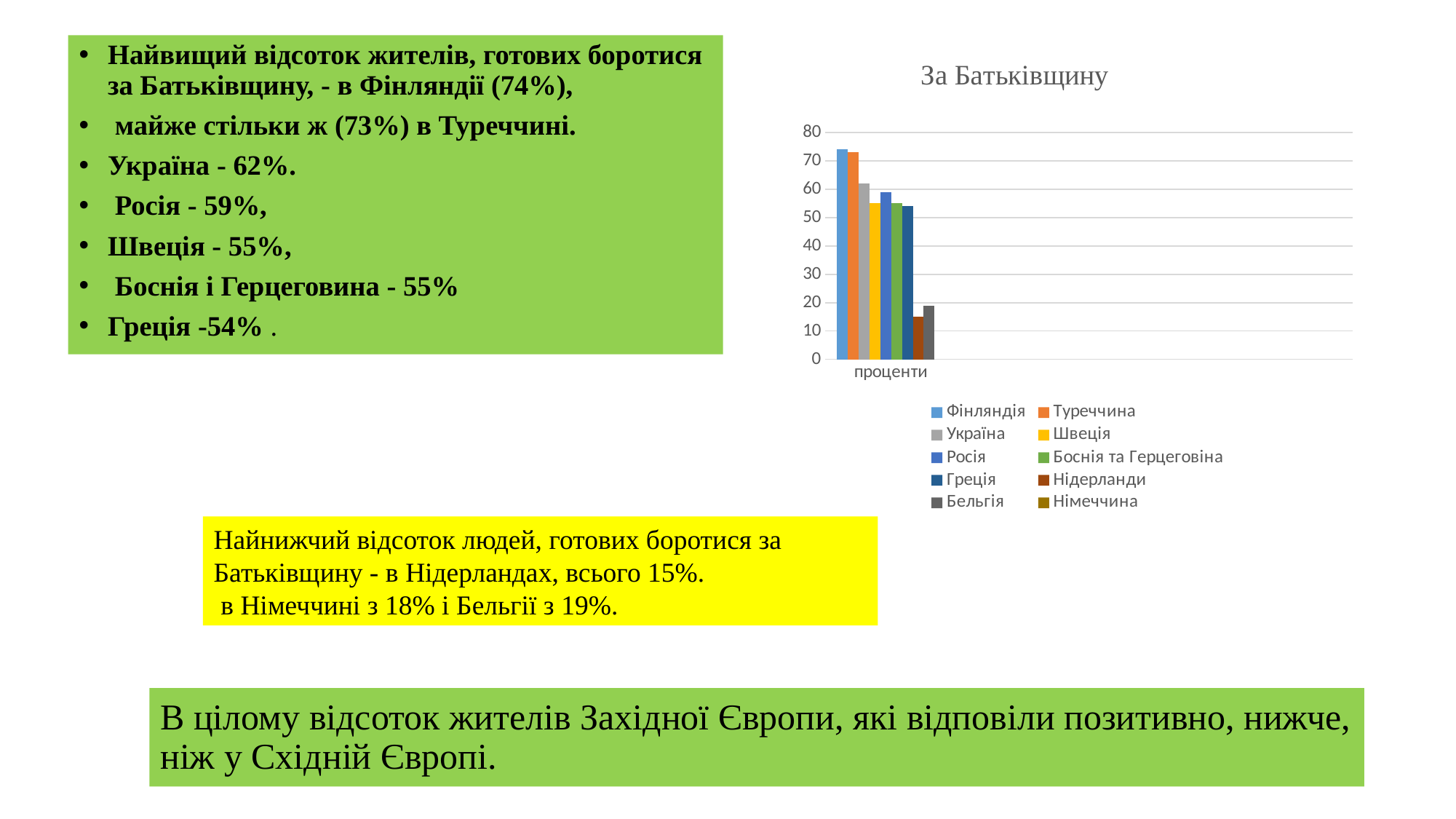
What kind of chart is shown on the slide? bar chart Is the value for Україна greater or less than 60? greater How many series does the chart legend list? 10 Which is larger, the value for Фінляндія or the value for Нідерланди? Фінляндія Which series has the lowest bar in the chart? Нідерланди What label is shown on the x axis under the bars? проценти Is the value for Нідерланди greater or less than 20? less Is the value for Швеція greater or less than 50? greater Which is larger, the value for Україна or the value for Росія? Україна What is the title of the chart? За Батьківщину